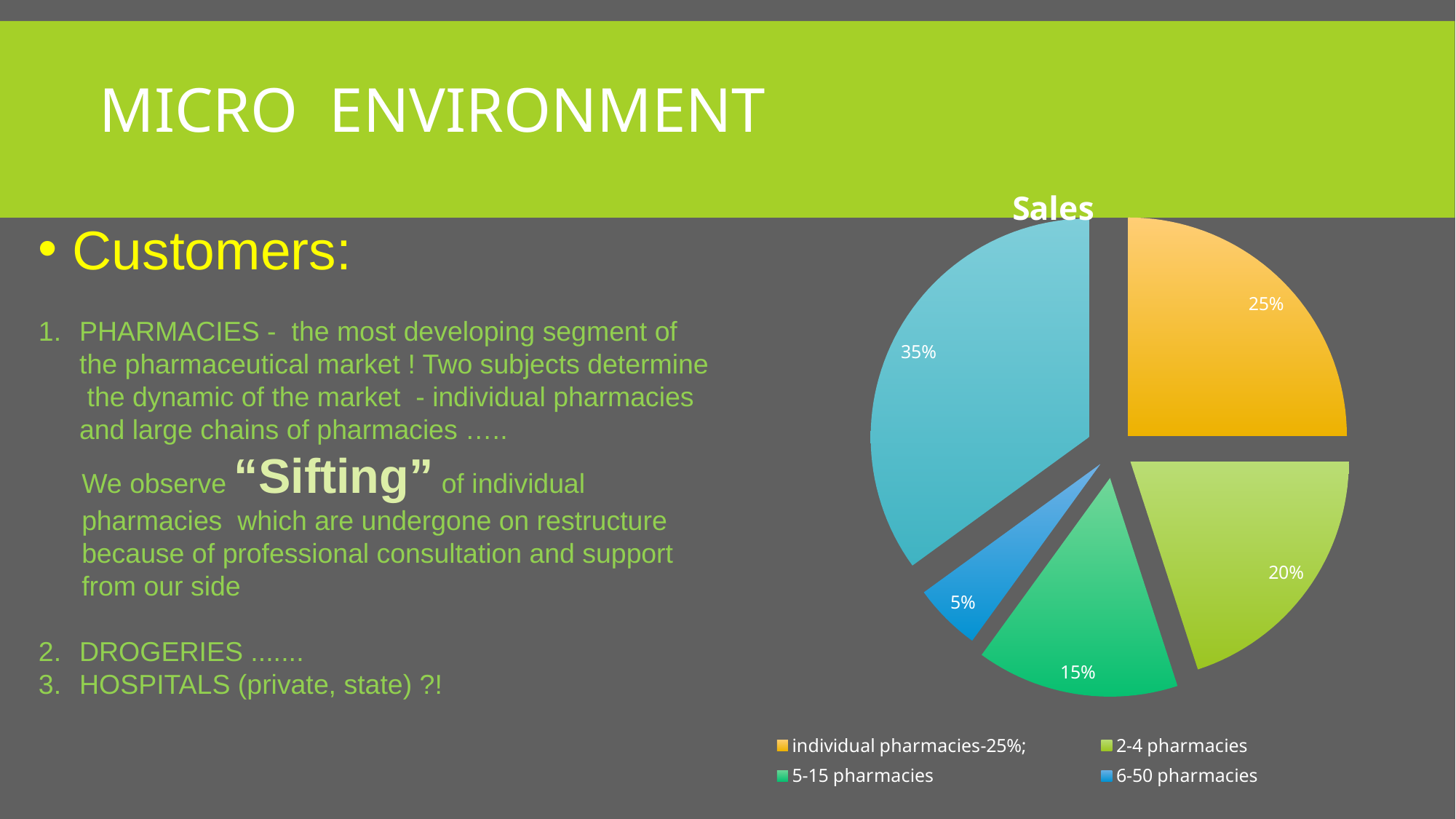
What type of chart is shown on the slide? pie chart How many entries does the legend of the Sales pie chart list? 4 Which legend category has the smallest slice in the Sales pie chart? 6-50 pharmacies What percentage of the Sales pie is for 5-15 pharmacies? 15% What is the largest percentage value shown on the Sales pie chart? 35% What percentage of the Sales pie is for 2-4 pharmacies? 20% What percentage of the Sales pie is for 6-50 pharmacies? 5% Which is larger in the Sales pie chart: 2-4 pharmacies or 6-50 pharmacies? 2-4 pharmacies How many slices does the Sales pie chart have? 5 What is the difference between the individual pharmacies slice and the 5-15 pharmacies slice? 10% What percentage of the Sales pie is for individual pharmacies? 25% What is the title of the pie chart? Sales